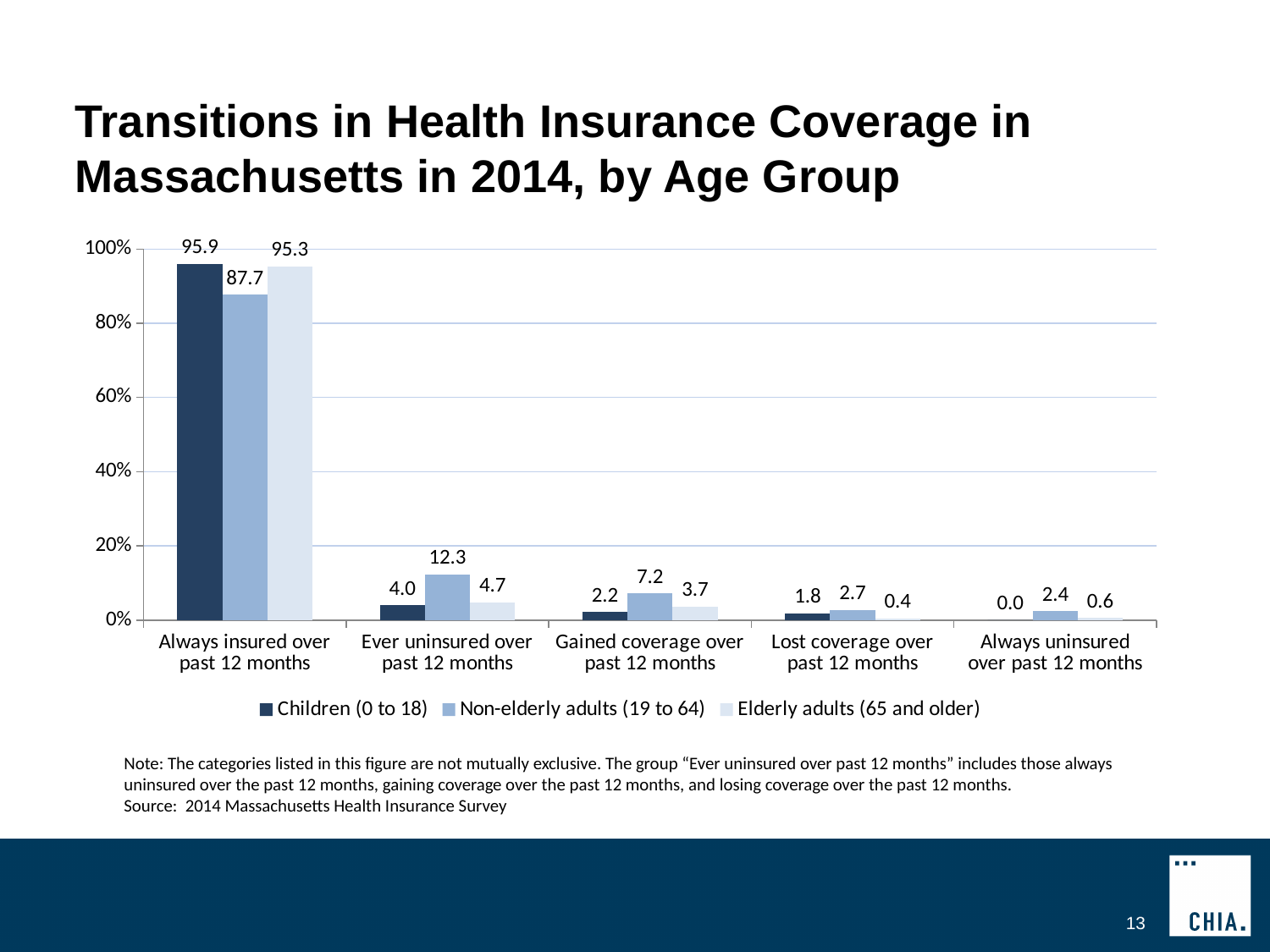
How many series does the legend list? 3 What is the value for Elderly adults (65 and older) in the 'Lost coverage over past 12 months' category? 0.4 Which age group has the highest value in the 'Gained coverage over past 12 months' category? Non-elderly adults (19 to 64) What is the value for Children (0 to 18) in the 'Always uninsured over past 12 months' category? 0.0 Which age group has the lowest value in the 'Always insured over past 12 months' category? Non-elderly adults (19 to 64) What kind of chart is shown on the slide? Bar chart What is the value for Children (0 to 18) in the 'Always insured over past 12 months' category? 95.9 What is the difference between the Children (0 to 18) and Non-elderly adults (19 to 64) values in the 'Always insured over past 12 months' category? 8.2 Is the value for Non-elderly adults (19 to 64) in the 'Always insured over past 12 months' category greater or less than 80%? greater Which is larger in the 'Ever uninsured over past 12 months' category: the value for Children (0 to 18) or for Elderly adults (65 and older)? Elderly adults (65 and older) What is the value for Non-elderly adults (19 to 64) in the 'Ever uninsured over past 12 months' category? 12.3 How many categories are shown on the x axis? 5